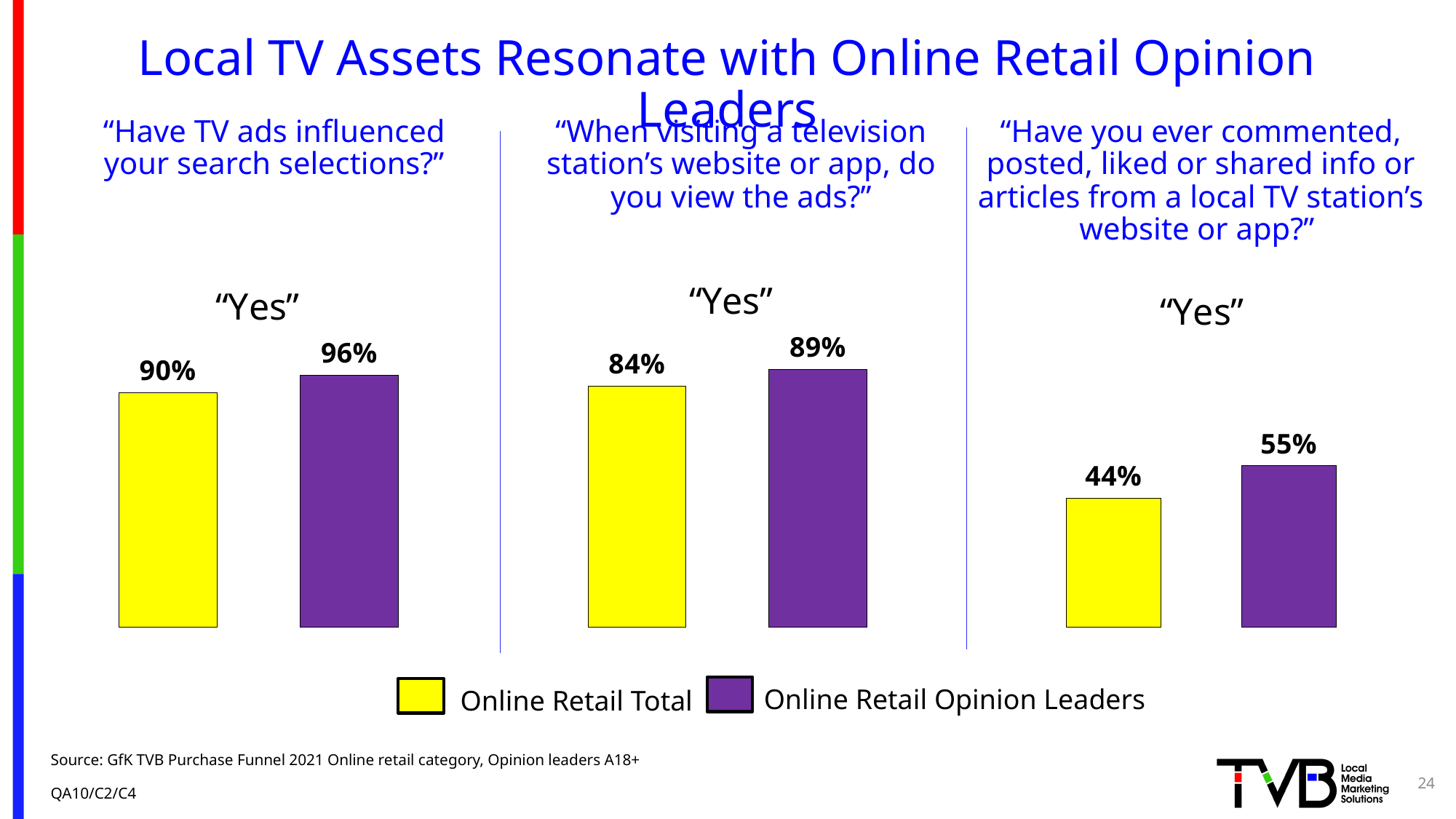
How many series does the legend at the bottom of the slide list? 2 Which series is shown in yellow in the legend? Online Retail Total In the middle chart, which series has the larger value: Online Retail Total or Online Retail Opinion Leaders? Online Retail Opinion Leaders In the left chart ("Have TV ads influenced your search selections?"), what percentage of Online Retail Opinion Leaders answered "Yes"? 96% In the left chart, what is the difference between the Online Retail Opinion Leaders value and the Online Retail Total value? 6% In the left chart ("Have TV ads influenced your search selections?"), what percentage of Online Retail Total answered "Yes"? 90% What kind of chart is used in each of the three panels on the slide? Bar chart In the right chart, what is the difference between the Online Retail Opinion Leaders value and the Online Retail Total value? 11% In the right chart ("Have you ever commented, posted, liked or shared info or articles from a local TV station's website or app?"), what is the value for Online Retail Opinion Leaders? 55% In the middle chart ("When visiting a television station's website or app, do you view the ads?"), what is the value for Online Retail Opinion Leaders? 89% In the right chart ("Have you ever commented, posted, liked or shared info or articles from a local TV station's website or app?"), what is the value for Online Retail Total? 44% In the middle chart ("When visiting a television station's website or app, do you view the ads?"), what is the value for Online Retail Total? 84%